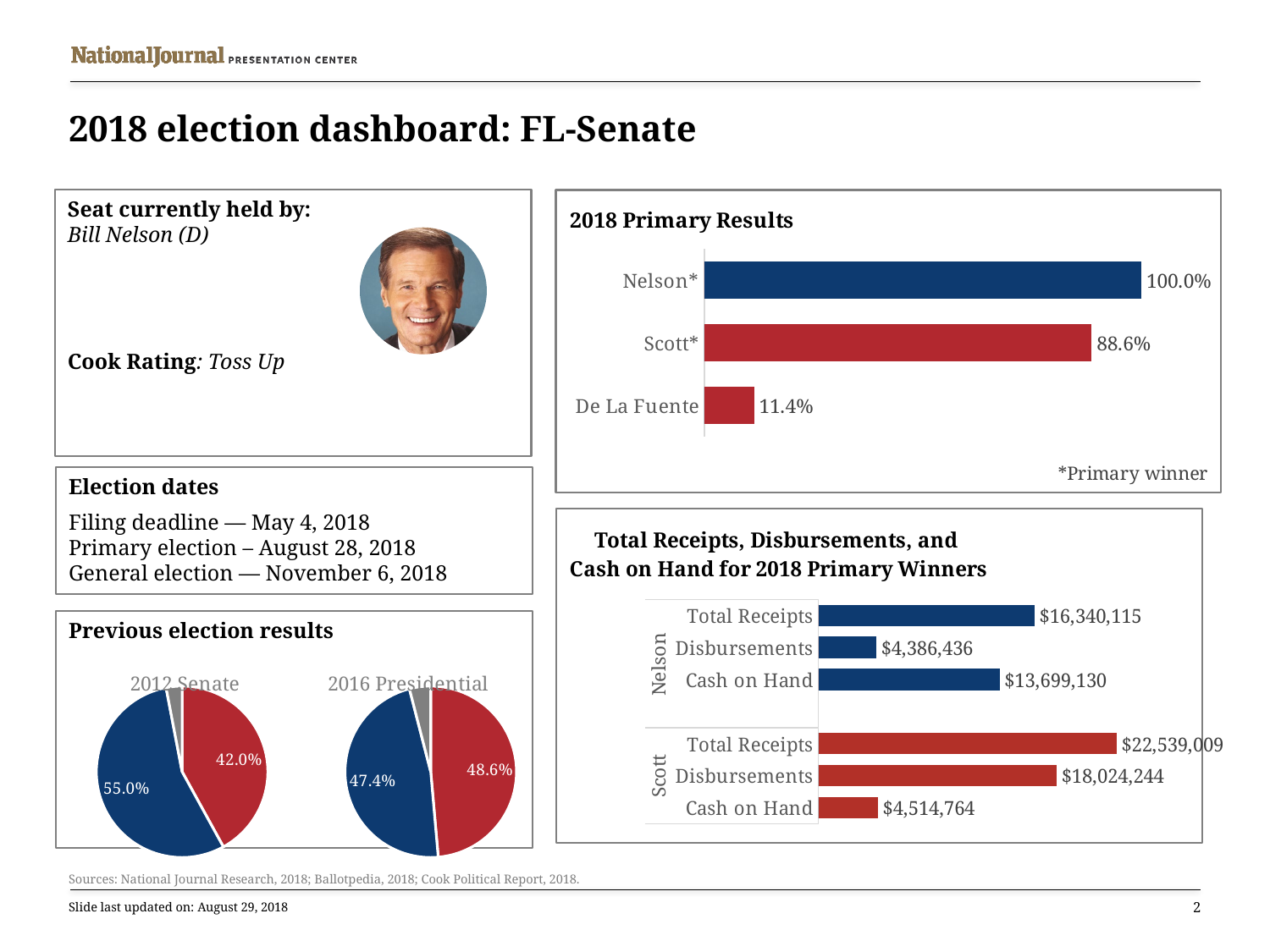
In the 2016 Presidential pie chart, what share is shown for the red slice? 48.6% In the 2012 Senate pie chart, what share is shown for the blue slice? 55.0% In the 2018 Primary Results chart, what value is shown for De La Fuente? 11.4% In the 2018 Primary Results chart, what value is shown for Scott*? 88.6% What kind of chart is the 2018 Primary Results chart? Bar chart In the Total Receipts, Disbursements, and Cash on Hand chart, what is Nelson's Cash on Hand? $13,699,130 In the 2018 Primary Results chart, which candidate has the lowest value? De La Fuente In the Total Receipts, Disbursements, and Cash on Hand chart, which candidate has the higher Total Receipts? Scott In the 2018 Primary Results chart, how many candidates are shown? 3 In the Total Receipts, Disbursements, and Cash on Hand chart, what are Scott's Disbursements? $18,024,244 In the Total Receipts, Disbursements, and Cash on Hand chart, what is the difference between Scott's Total Receipts and Nelson's Total Receipts? $6,198,894 In the Total Receipts, Disbursements, and Cash on Hand chart, which bar is the shortest? Nelson Disbursements